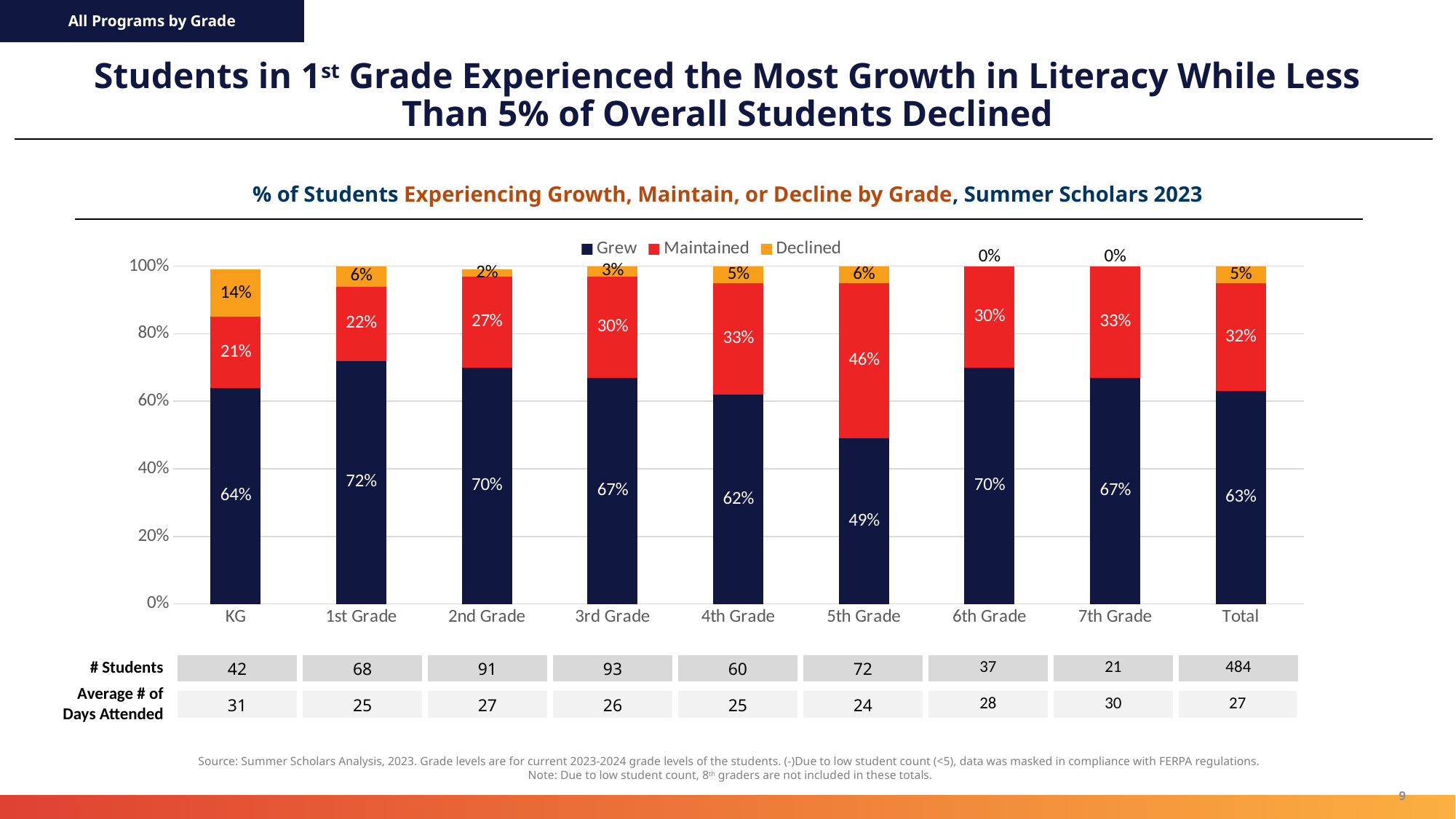
Which has a larger Grew percentage, 2nd Grade or 4th Grade? 2nd Grade Which grade has the highest Grew percentage? 1st Grade What percentage of 5th Grade students Maintained? 46% How many categories are shown on the x axis of the chart? 9 What type of chart is shown on the slide? Stacked bar chart What is the difference in percentage points between the Grew value for 1st Grade and the Grew value for 5th Grade? 23 percentage points What is the Grew percentage for the Total bar? 63% What percentage of 1st Grade students Grew? 72% Which grade has the lowest Grew percentage? 5th Grade What percentage of KG students Declined? 14% How many series does the chart legend list? 3 Which category has the highest Declined percentage? KG